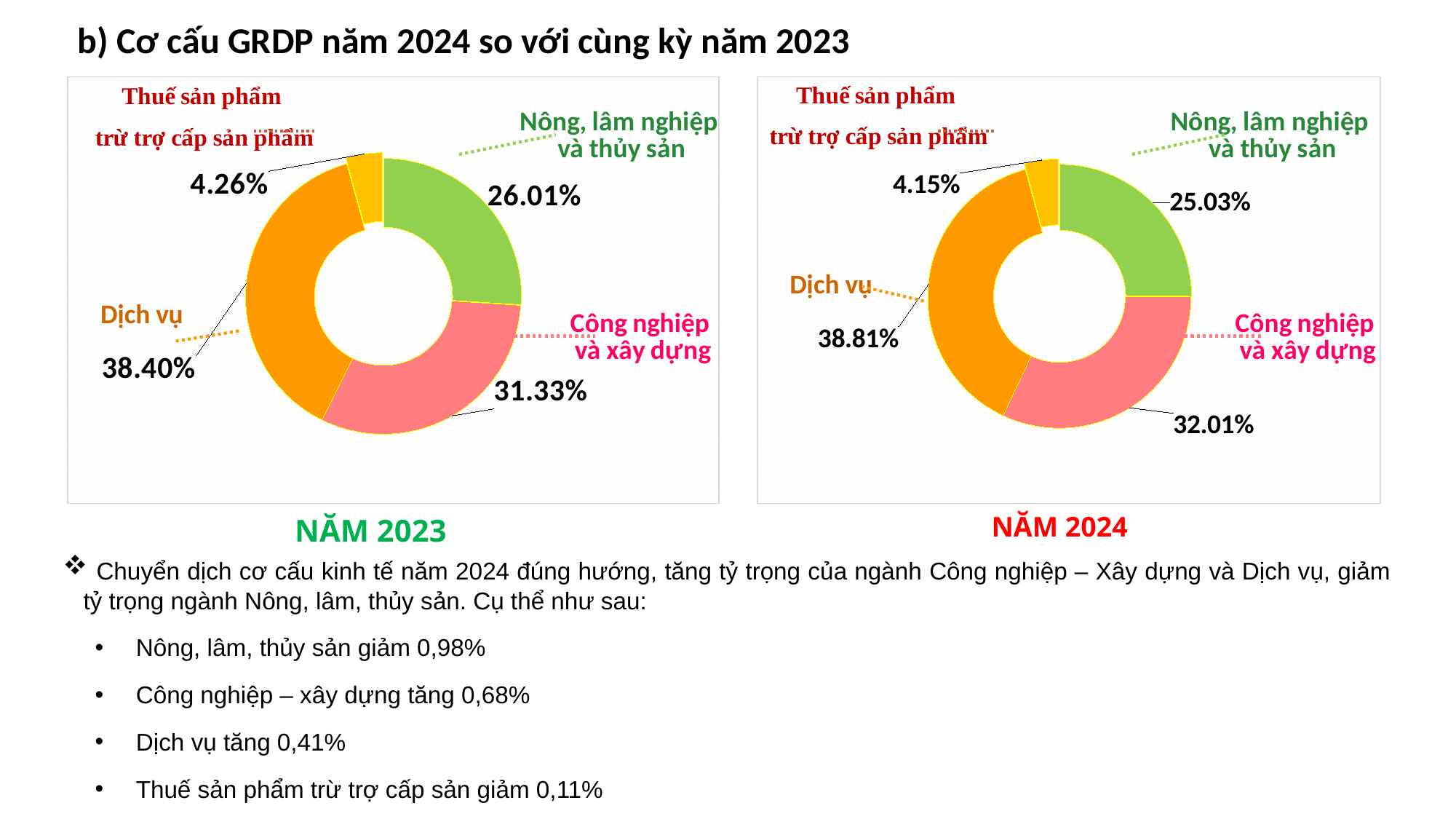
In the NĂM 2023 chart, what share does Dịch vụ have? 38.40% In the NĂM 2023 chart, which category has the smallest share? Thuế sản phẩm trừ trợ cấp sản phẩm In the NĂM 2024 chart, what share does Công nghiệp và xây dựng have? 32.01% In the NĂM 2024 chart, what share does Nông, lâm nghiệp và thủy sản have? 25.03% In the NĂM 2023 chart, what share does Thuế sản phẩm trừ trợ cấp sản phẩm have? 4.26% In the NĂM 2023 chart, what colour is the Công nghiệp và xây dựng slice? Pink In the NĂM 2023 chart, what is the difference between the Dịch vụ share and the Công nghiệp và xây dựng share? 7.07% How many categories does the NĂM 2024 chart show? 4 In the NĂM 2024 chart, which is larger: Nông, lâm nghiệp và thủy sản or Công nghiệp và xây dựng? Công nghiệp và xây dựng In the NĂM 2024 chart, which category has the largest share? Dịch vụ What kind of chart is the NĂM 2023 chart? Doughnut (pie) chart What is the difference between the Dịch vụ share in the NĂM 2024 chart and in the NĂM 2023 chart? 0.41%